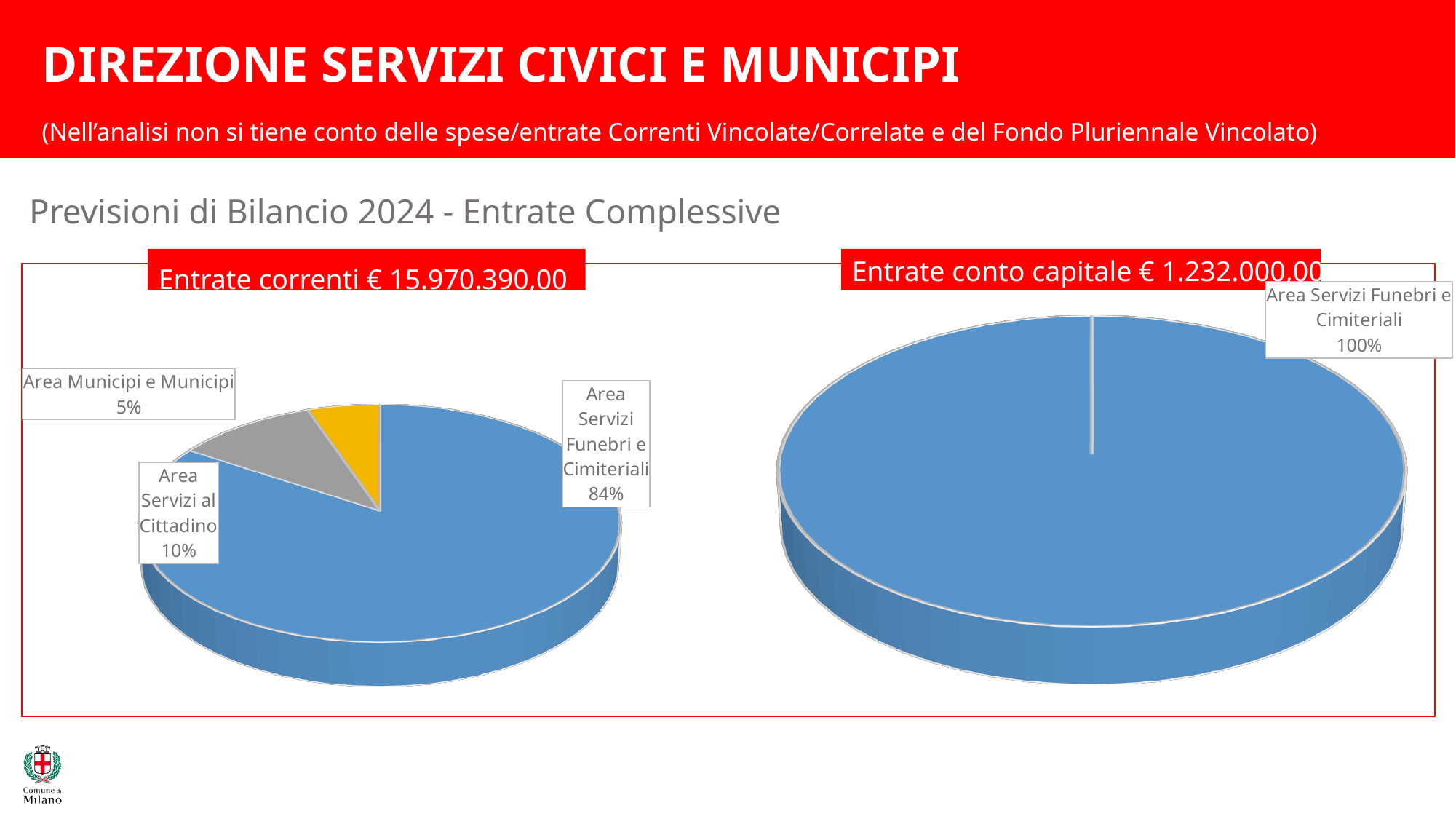
In the 'Entrate correnti' pie chart, what share does Area Servizi al Cittadino have? 10% In the 'Entrate conto capitale' pie chart, what share does Area Servizi Funebri e Cimiteriali have? 100% What total amount is shown in the label above the 'Entrate conto capitale' chart? € 1.232.000,00 What kind of chart is used on the left side of the slide? Pie chart In the 'Entrate correnti' pie chart, what share does Area Servizi Funebri e Cimiteriali have? 84% In the 'Entrate correnti' pie chart, what is the difference in percentage points between Area Servizi Funebri e Cimiteriali and Area Servizi al Cittadino? 74 In the 'Entrate correnti' pie chart, which area has the largest share? Area Servizi Funebri e Cimiteriali In the 'Entrate correnti' pie chart, which area has the smallest share? Area Municipi e Municipi In the 'Entrate correnti' pie chart, which is larger: Area Servizi al Cittadino or Area Municipi e Municipi? Area Servizi al Cittadino In the 'Entrate correnti' pie chart, how many slices are there? 3 In the 'Entrate conto capitale' pie chart, how many areas are shown? 1